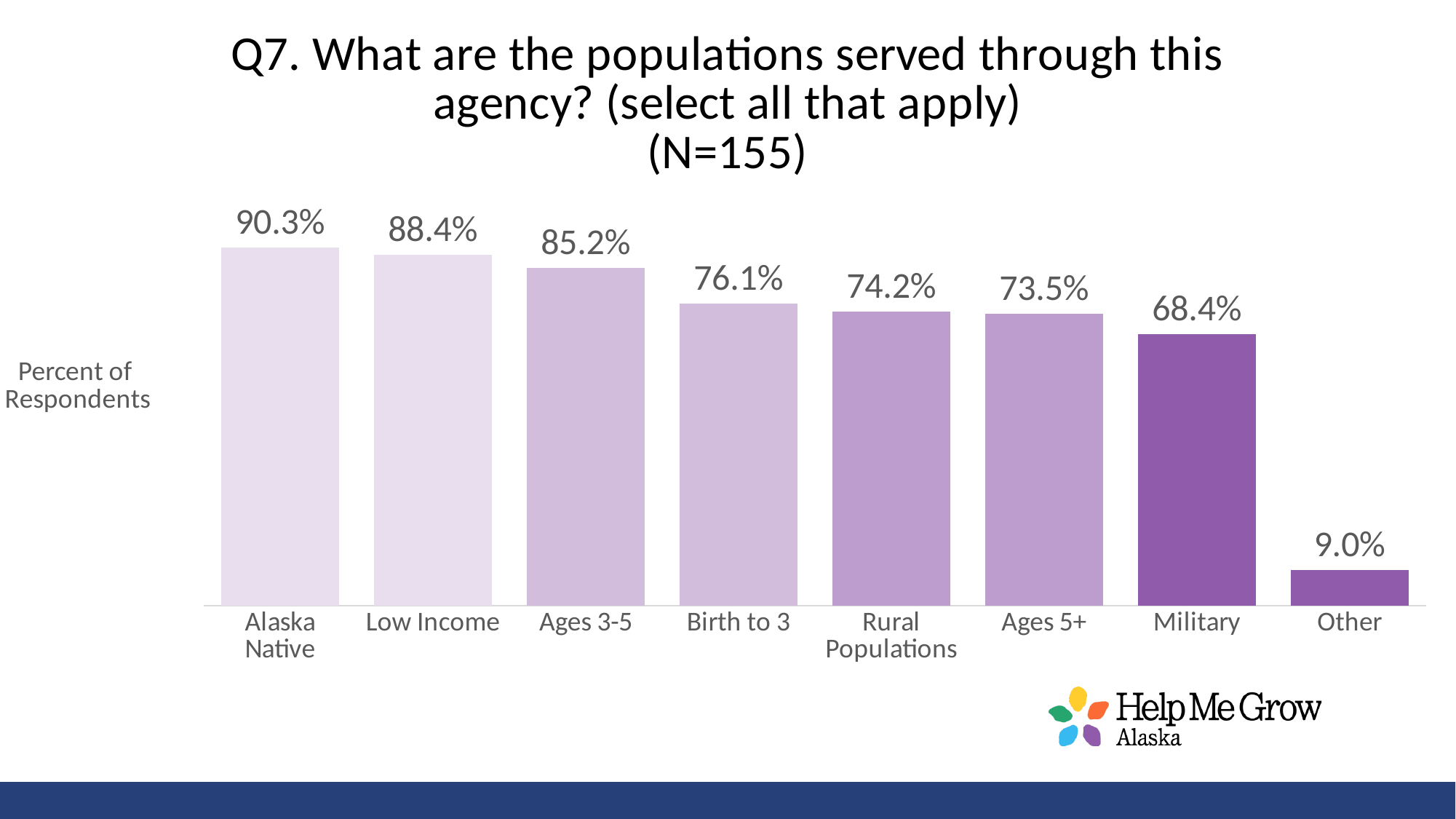
Which is larger, the value for Low Income or the value for Ages 5+? Low Income What is the difference between the values for Alaska Native and Low Income? 1.9% What is the sample size (N) stated in the chart title? 155 How many population categories are shown in the chart? 8 What is the value for Birth to 3? 76.1% What percentage of respondents serve Alaska Native populations? 90.3% What is the difference between the values for Ages 3-5 and Military? 16.8% Which population category has the highest percentage of respondents? Alaska Native What is the value for Military? 68.4% Which population category has the lowest percentage of respondents? Other What percentage of respondents serve Rural Populations? 74.2% What kind of chart is shown on the slide? Bar chart